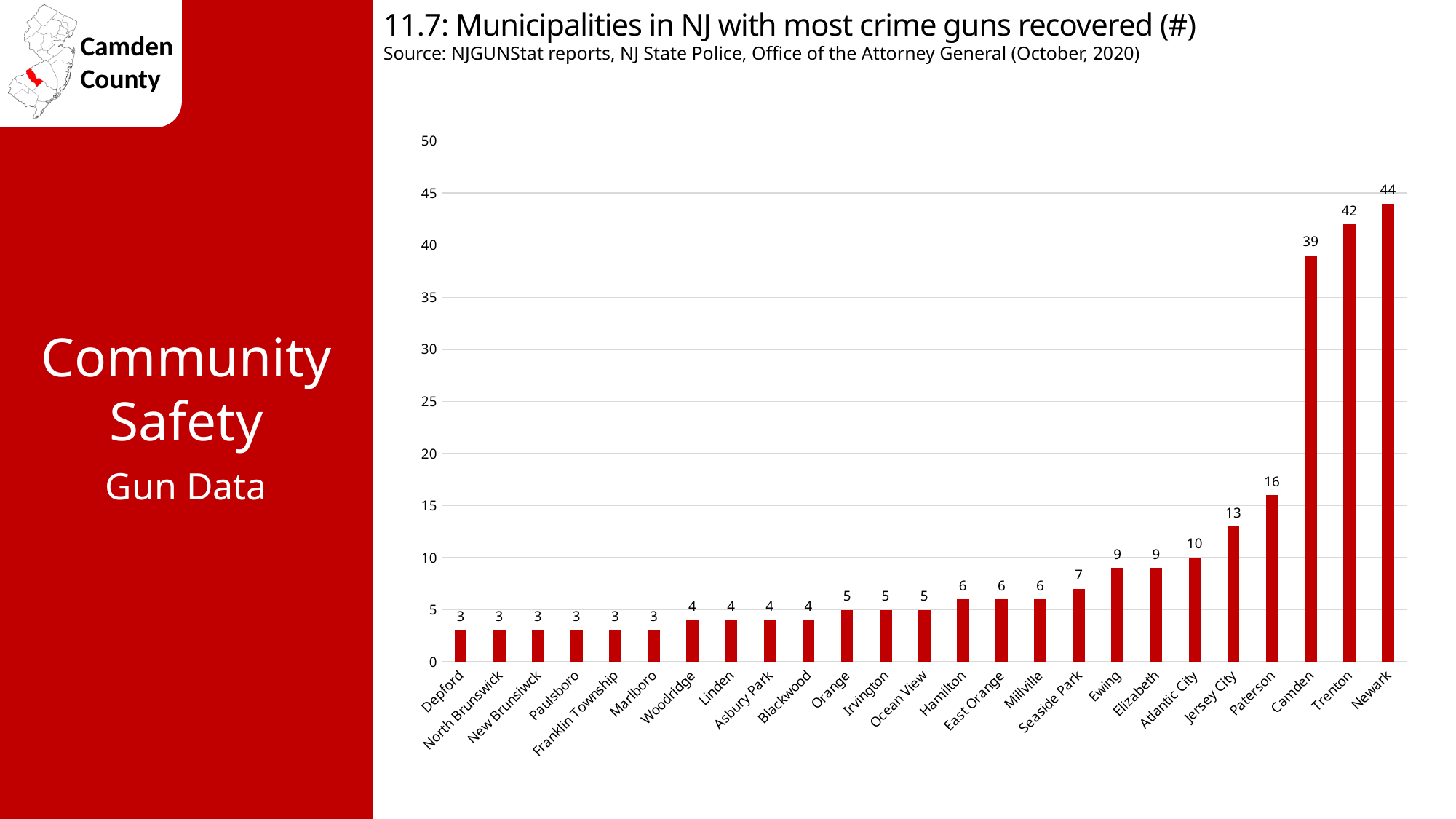
What type of chart is shown on the slide? bar chart What is the difference between the values for Newark and Camden? 5 Which municipality has the highest number of crime guns recovered? Newark Do the values generally rise or fall from left to right along the x axis? rise How many crime guns were recovered in Atlantic City? 10 Which has a higher value, Elizabeth or Seaside Park? Elizabeth How many crime guns were recovered in Trenton? 42 What is the difference between the values for Jersey City and Paterson? 3 How many crime guns were recovered in Camden? 39 Is the value for Trenton greater or less than 40? greater How many municipalities are shown on the chart? 25 How many crime guns were recovered in Paterson? 16